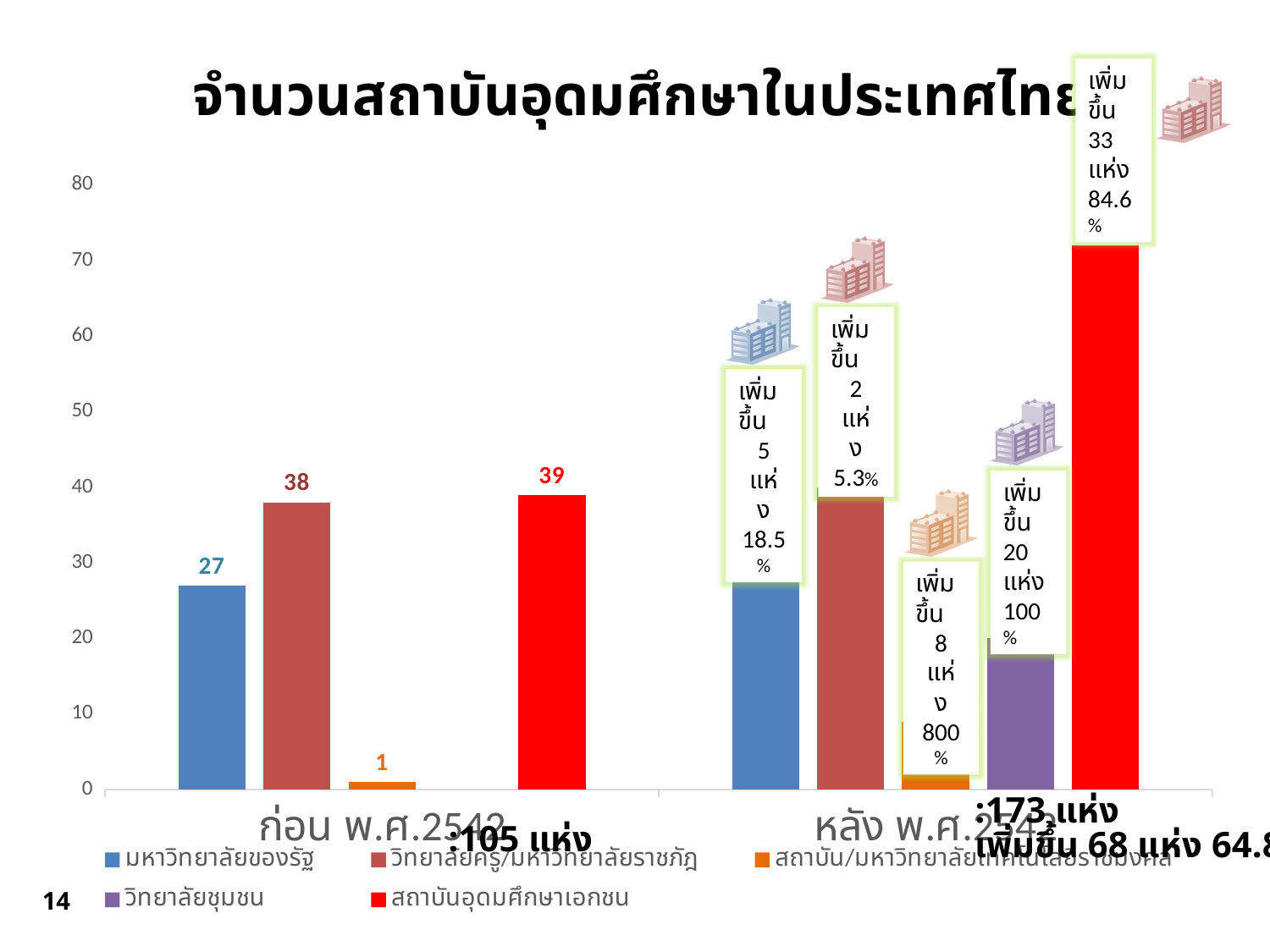
What is the value for วิทยาลัยครู/มหาวิทยาลัยราชภัฏ in the ก่อน พ.ศ.2542 category? 38 How many categories are shown on the x axis? 2 Is the value for มหาวิทยาลัยของรัฐ in the หลัง พ.ศ.2542 category greater or less than 40? less How many series does the legend list? 5 In the ก่อน พ.ศ.2542 category, what is the difference between สถาบันอุดมศึกษาเอกชน and มหาวิทยาลัยของรัฐ? 12 Which series has the highest value in the ก่อน พ.ศ.2542 category? สถาบันอุดมศึกษาเอกชน Is the value for สถาบันอุดมศึกษาเอกชน in the หลัง พ.ศ.2542 category greater or less than 60? greater What is the value for สถาบันอุดมศึกษาเอกชน in the ก่อน พ.ศ.2542 category? 39 What kind of chart is shown on the slide? bar chart What is the value for มหาวิทยาลัยของรัฐ in the ก่อน พ.ศ.2542 category? 27 Which series has the lowest value in the ก่อน พ.ศ.2542 category? สถาบัน/มหาวิทยาลัยเทคโนโลยีราชมงคล In the ก่อน พ.ศ.2542 category, which is larger: มหาวิทยาลัยของรัฐ or วิทยาลัยครู/มหาวิทยาลัยราชภัฏ? วิทยาลัยครู/มหาวิทยาลัยราชภัฏ